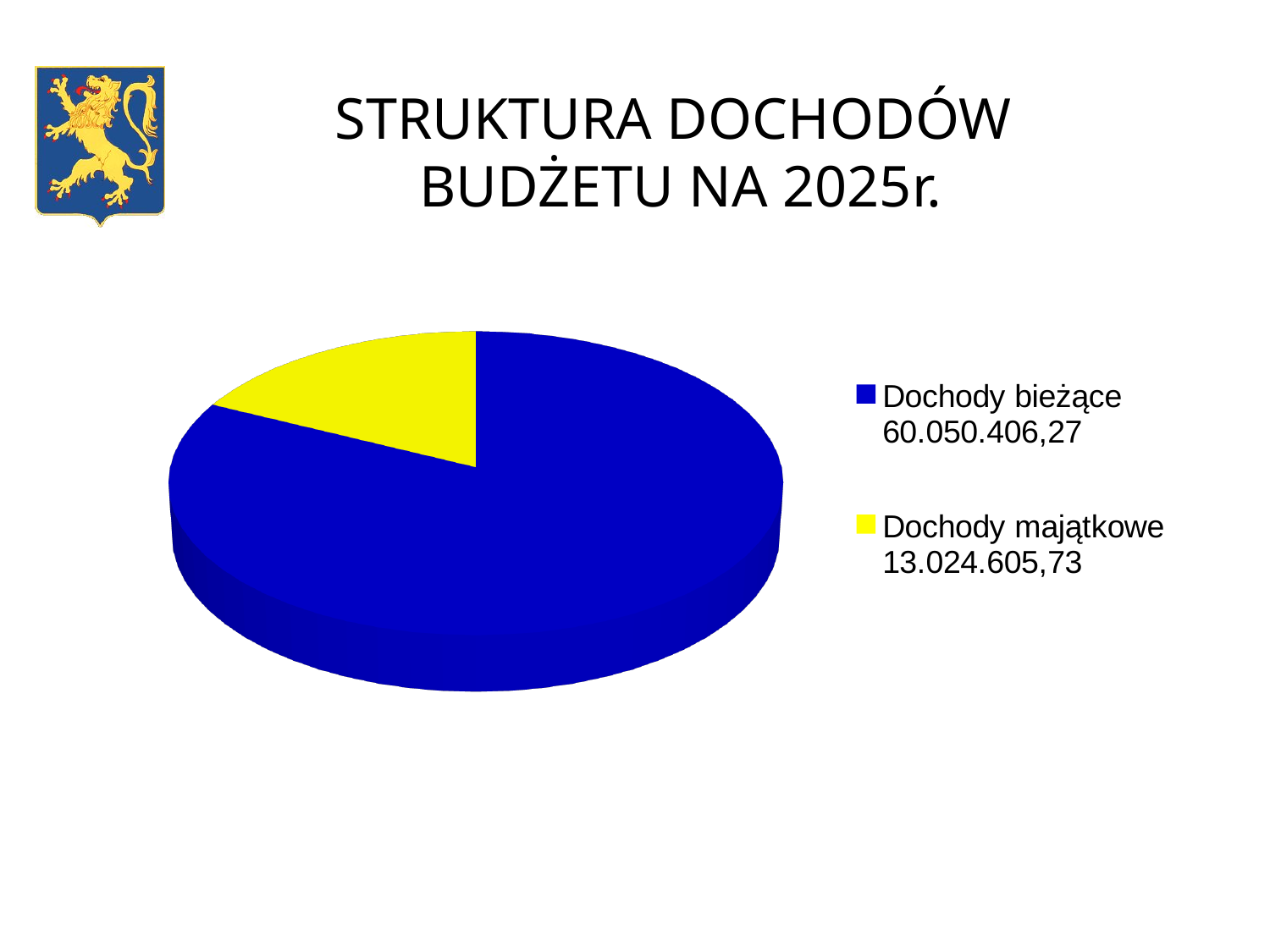
Which category has the largest slice of the pie? Dochody bieżące What is the value for Dochody majątkowe? 13.024.605,73 What is the difference between Dochody bieżące and Dochody majątkowe? 47.025.800,54 How many slices does the pie chart have? 2 What is the value for Dochody bieżące? 60.050.406,27 What is the total of the two values shown in the pie chart? 73.075.012,00 Which is larger, Dochody bieżące or Dochody majątkowe? Dochody bieżące What is the title of the slide containing the chart? STRUKTURA DOCHODÓW BUDŻETU NA 2025r. What kind of chart is shown on the slide? pie chart Which category has the smallest slice of the pie? Dochody majątkowe What colour is the slice for Dochody majątkowe? yellow How many entries does the legend list? 2